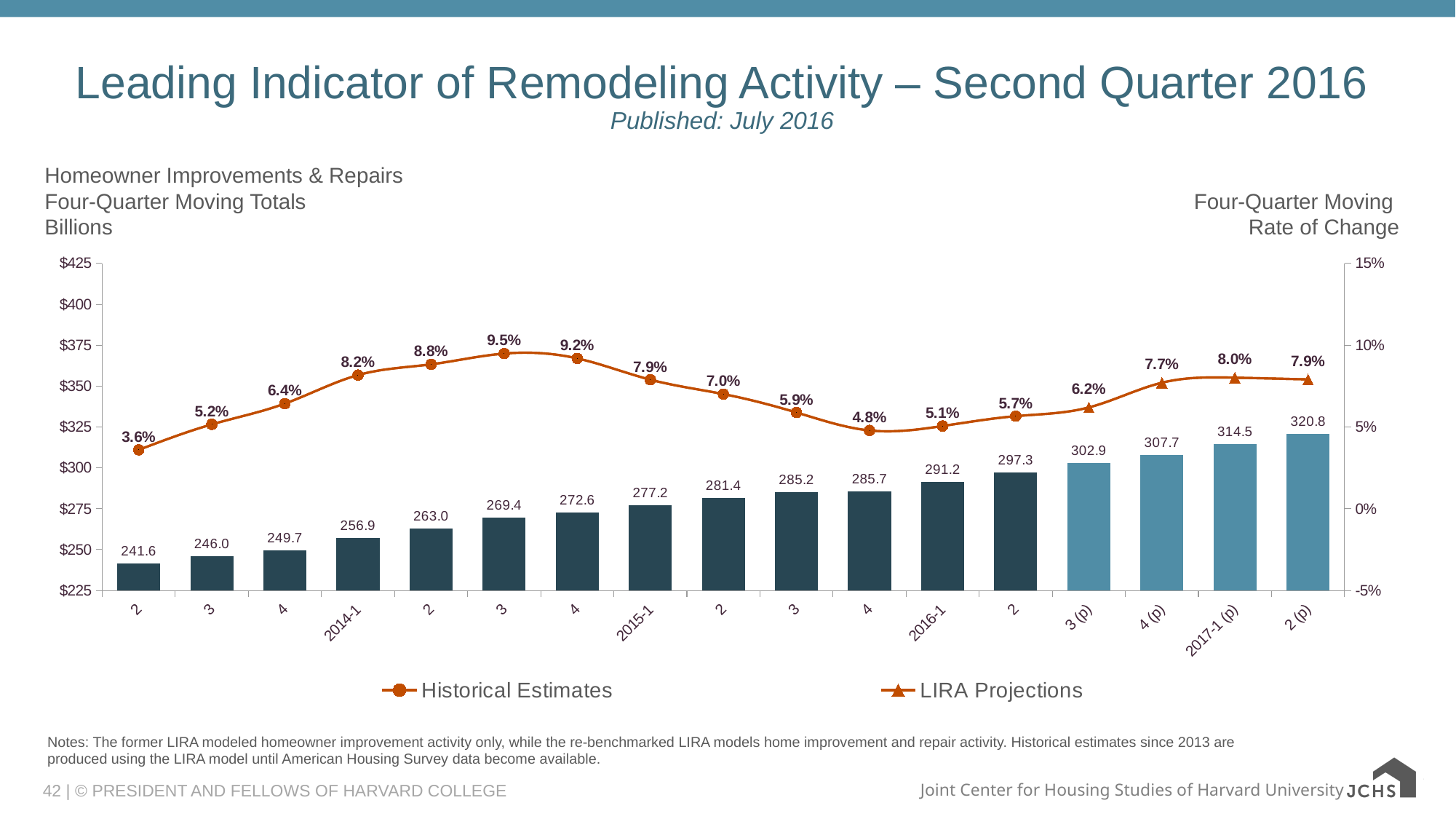
Do the four-quarter moving totals (bars) rise or fall from left to right across the chart? rise Which quarter has the highest four-quarter moving rate of change on the line? 2014 Q3 (the point labeled 9.5%, category "3" after 2014-1) What is the four-quarter moving rate of change shown for 2014-1? 8.2% What is the lowest four-quarter moving rate of change shown on the line? 3.6% Is the four-quarter moving total for 2015-1 greater or less than $275? greater What kind of chart is used to show the four-quarter moving totals in billions? bar chart How many bars are plotted in the chart? 17 What is the four-quarter moving total (in billions) for 2016-1? 291.2 Which is larger, the rate of change for 2015-1 or for 2016-1? 2015-1 (7.9%) How many series does the legend list? 2 What is the projected four-quarter moving total for 2017-1 (p)? 314.5 What is the difference between the four-quarter moving totals for 2 (p) and 2016-1? 29.6